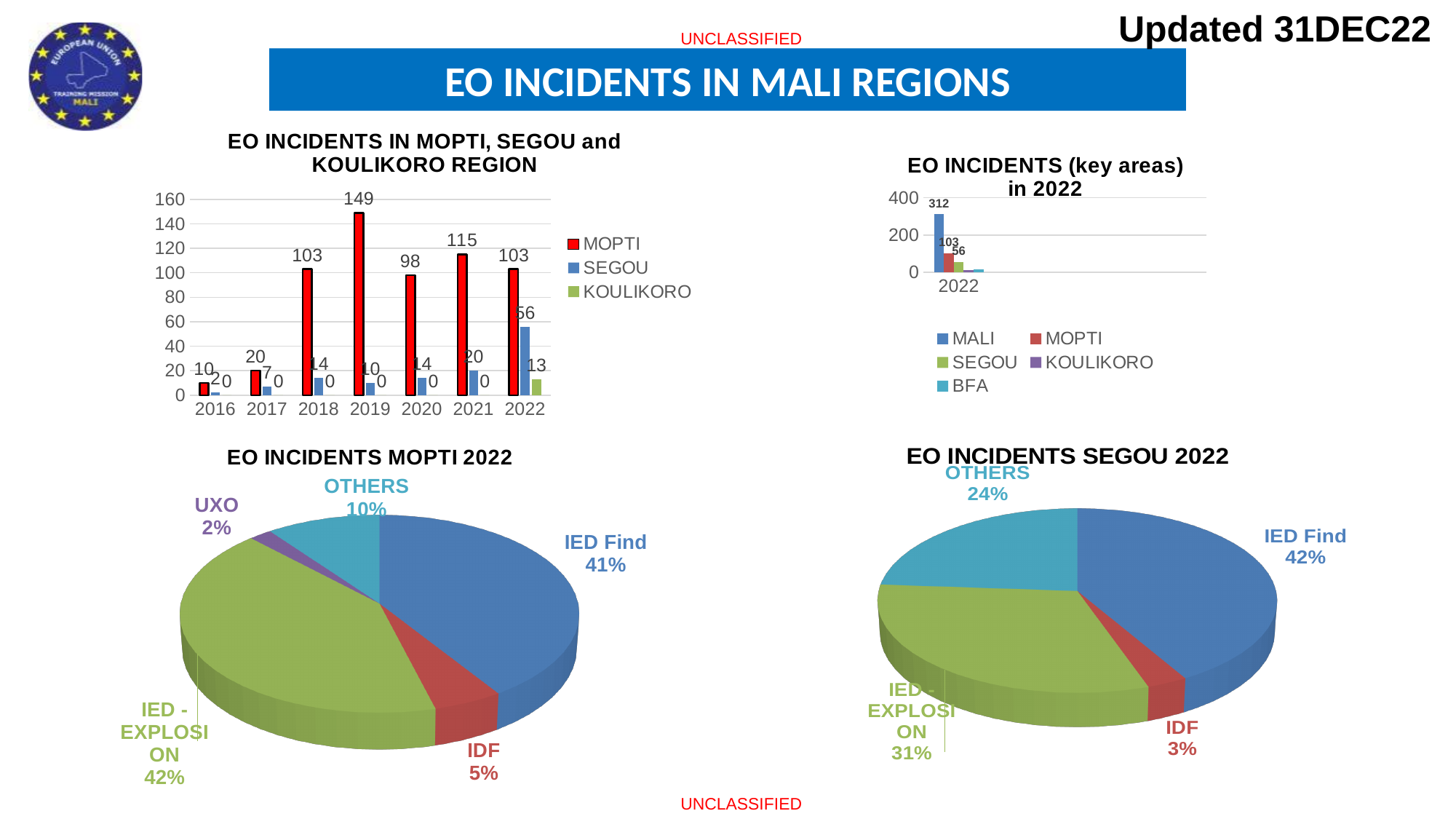
In the chart 'EO INCIDENTS IN MOPTI, SEGOU and KOULIKORO REGION', how many series does the legend list? 3 In the chart 'EO INCIDENTS IN MOPTI, SEGOU and KOULIKORO REGION', what is the difference between the MOPTI values for 2021 and 2020? 17 In the pie chart 'EO INCIDENTS SEGOU 2022', what share does OTHERS have? 24% In the chart 'EO INCIDENTS (key areas) in 2022', how many series does the legend list? 5 In the pie chart 'EO INCIDENTS SEGOU 2022', which category has the largest share? IED Find What kind of chart is 'EO INCIDENTS MOPTI 2022'? Pie chart In the chart 'EO INCIDENTS IN MOPTI, SEGOU and KOULIKORO REGION', what is the SEGOU value for 2022? 56 In the chart 'EO INCIDENTS (key areas) in 2022', what is the value for MALI? 312 In the chart 'EO INCIDENTS IN MOPTI, SEGOU and KOULIKORO REGION', how many years are shown on the x axis? 7 In the pie chart 'EO INCIDENTS MOPTI 2022', what share does UXO have? 2% In the chart 'EO INCIDENTS IN MOPTI, SEGOU and KOULIKORO REGION', which year has the highest MOPTI value? 2019 In the chart 'EO INCIDENTS IN MOPTI, SEGOU and KOULIKORO REGION', what is the MOPTI value for 2019? 149